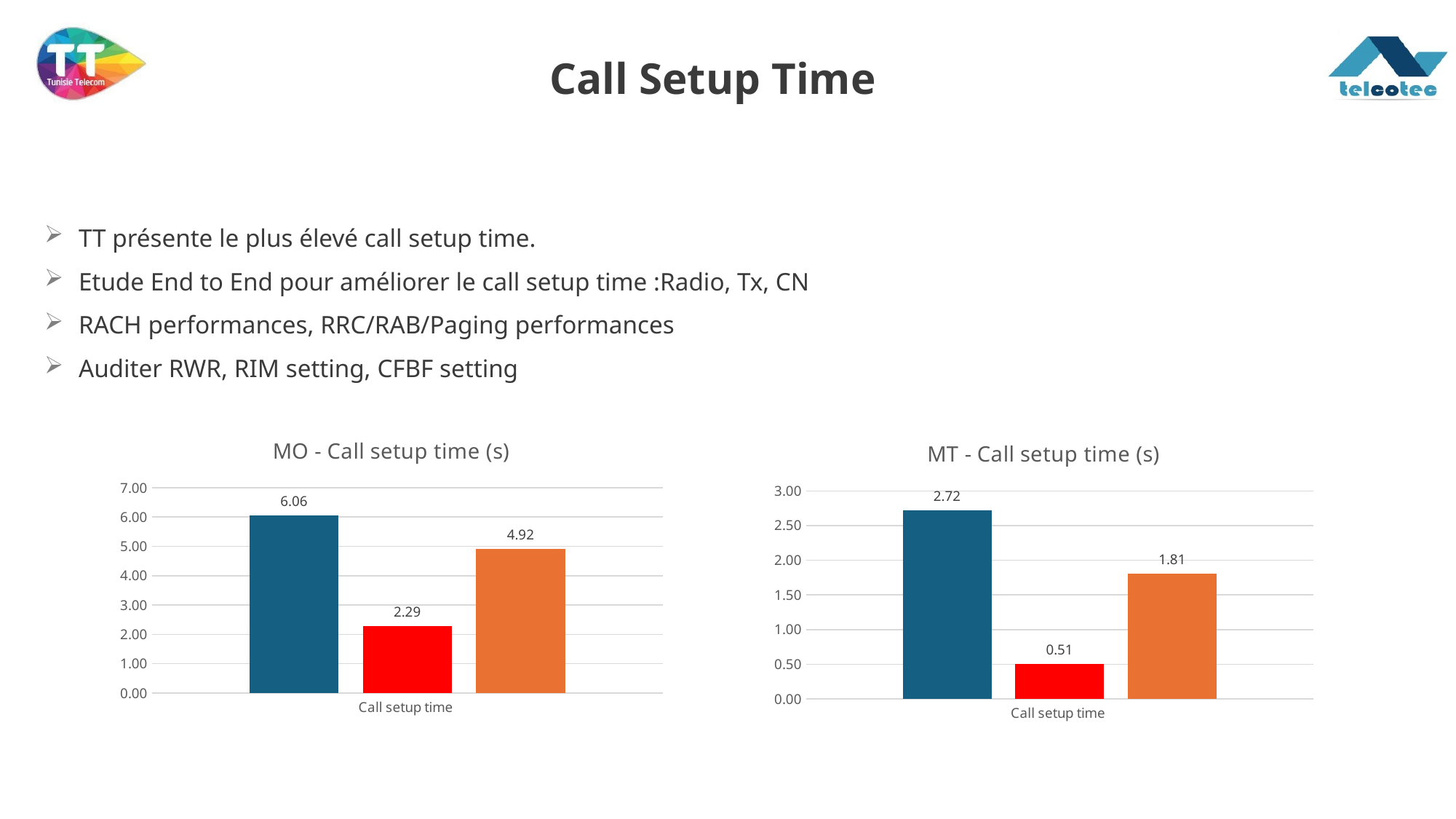
In the 'MO - Call setup time (s)' chart, what is the difference between the blue bar and the orange bar? 1.14 In the 'MO - Call setup time (s)' chart, what value is shown on the red bar? 2.29 What is the title of the chart on the left side of the slide? MO - Call setup time (s) In the 'MT - Call setup time (s)' chart, what is the difference between the blue bar and the red bar? 2.21 In the 'MT - Call setup time (s)' chart, which bar has the lowest value? The red bar (0.51) What type of chart is the 'MT - Call setup time (s)' chart? Bar chart In the 'MT - Call setup time (s)' chart, what value is shown on the red bar? 0.51 In the 'MT - Call setup time (s)' chart, what value is shown on the orange bar? 1.81 In the 'MT - Call setup time (s)' chart, is the orange bar's value greater or less than 2.00? less In the 'MO - Call setup time (s)' chart, how many bars are plotted? 3 In the 'MO - Call setup time (s)' chart, what value is shown on the blue bar? 6.06 In the 'MO - Call setup time (s)' chart, which bar has the highest value? The blue bar (6.06)